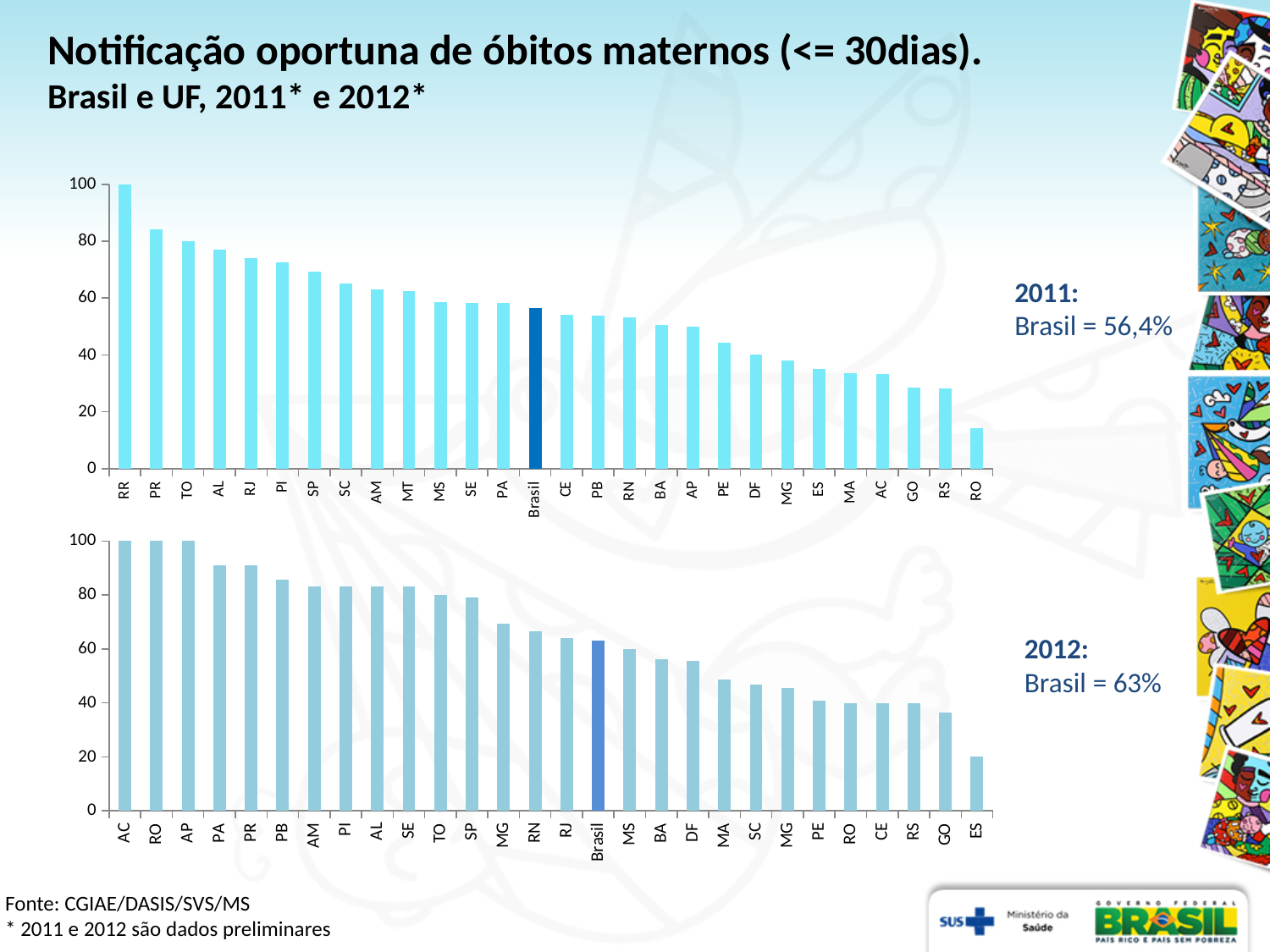
In the 2011 chart (top), which is larger, the value for PR or the value for TO? PR How many bars are plotted in the 2011 chart (top)? 28 In the 2012 chart (bottom), which UF has the lowest value? ES In the 2012 chart (bottom), is the value for GO greater or less than 40? less By how many percentage points did the Brasil value rise from 2011 to 2012? 6,6 In the 2011 chart (top), which UF has the lowest value? RO What kind of chart is used on this slide for the 2011 and 2012 data? Bar chart According to the slide, what is the value for Brasil in 2012? 63% In the 2011 chart (top), what is the value for RR? 100 In the 2011 chart (top), which UF has the highest value? RR According to the slide, what is the value for Brasil in 2011? 56,4% In the 2011 chart (top), is the value for PR greater or less than 80? greater